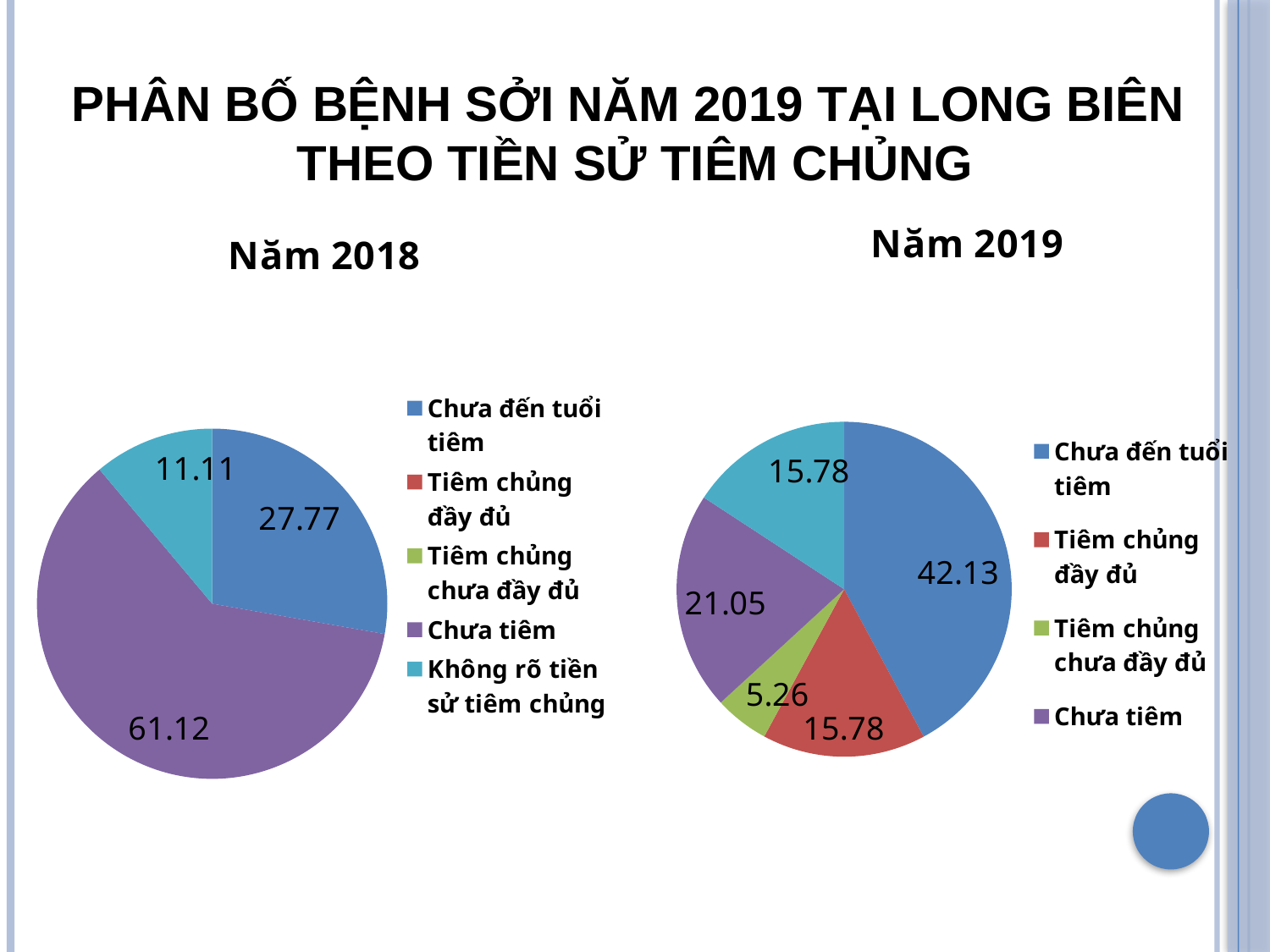
In the Năm 2019 chart, which is larger: Chưa đến tuổi tiêm or Chưa tiêm? Chưa đến tuổi tiêm In the Năm 2018 chart, what is the value for Chưa tiêm? 61.12 What type of chart is the Năm 2019 chart? Pie chart In the Năm 2019 chart, what is the value for Tiêm chủng chưa đầy đủ? 5.26 In the Năm 2019 chart, which category has the smallest slice? Tiêm chủng chưa đầy đủ In the Năm 2019 chart, what is the value for Chưa đến tuổi tiêm? 42.13 What is the difference between the Chưa tiêm values in the Năm 2018 chart and the Năm 2019 chart? 40.07 In the Năm 2019 chart, what is the value for Chưa tiêm? 21.05 How many entries does the legend of the Năm 2018 chart list? 5 In the Năm 2018 chart, what is the value for Chưa đến tuổi tiêm? 27.77 In the Năm 2018 chart, what is the value for Không rõ tiền sử tiêm chủng? 11.11 In the Năm 2018 chart, which category has the largest slice? Chưa tiêm